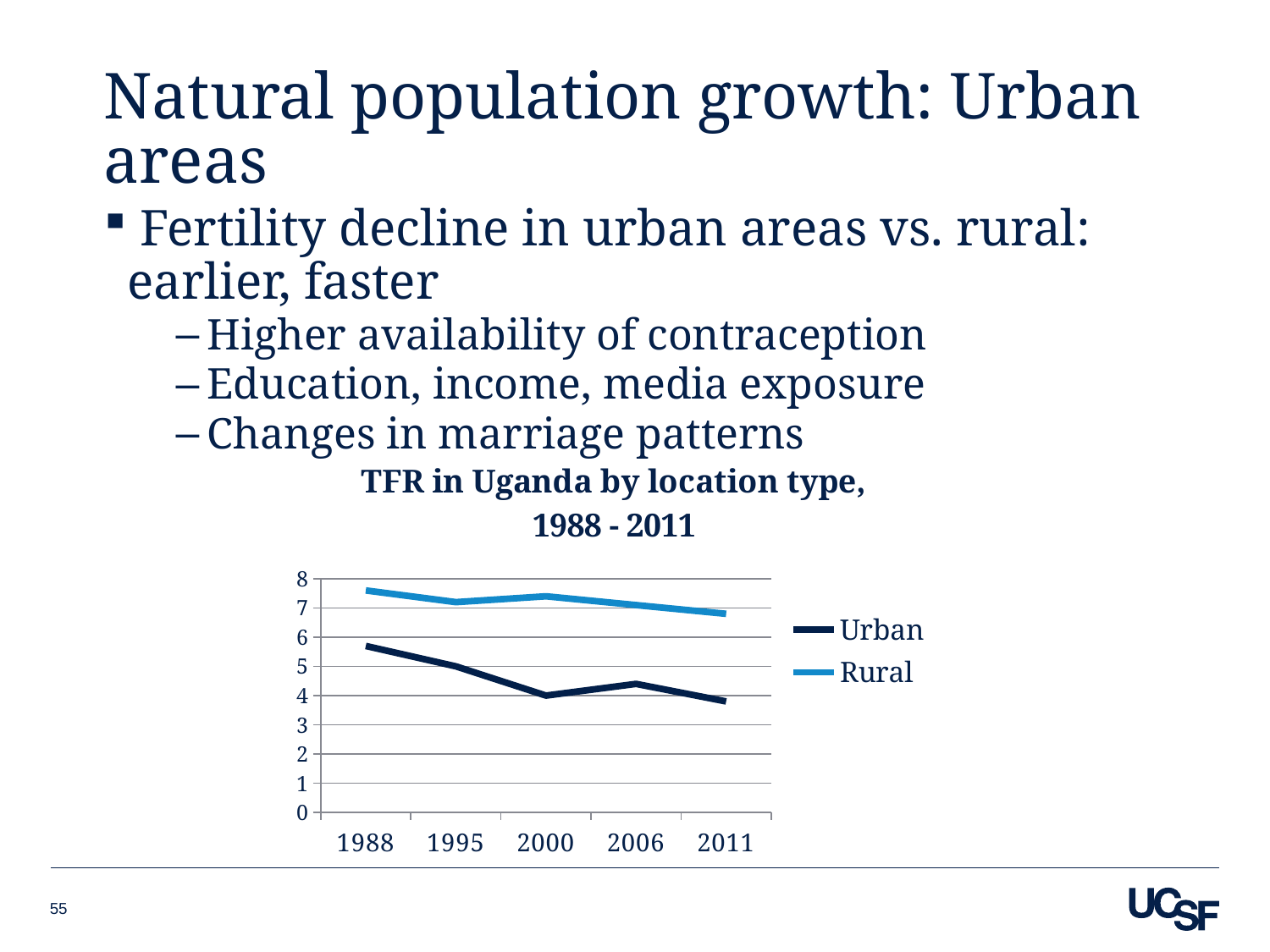
What is the title of the chart? TFR in Uganda by location type, 1988 - 2011 Is the Urban value for 1988 greater or less than 5? greater In which year is the Urban series at its highest? 1988 In 2011, which series has the higher value, Urban or Rural? Rural How many years are shown on the x axis of the chart? 5 Is the Urban value for 2000 greater or less than 5? less Is the Rural value for 1988 greater or less than 7? greater What kind of chart is shown on the slide? line chart Does the Urban series generally rise or fall from 1988 to 2011? fall Which series is drawn in the lighter blue line? Rural How many series does the chart's legend list? 2